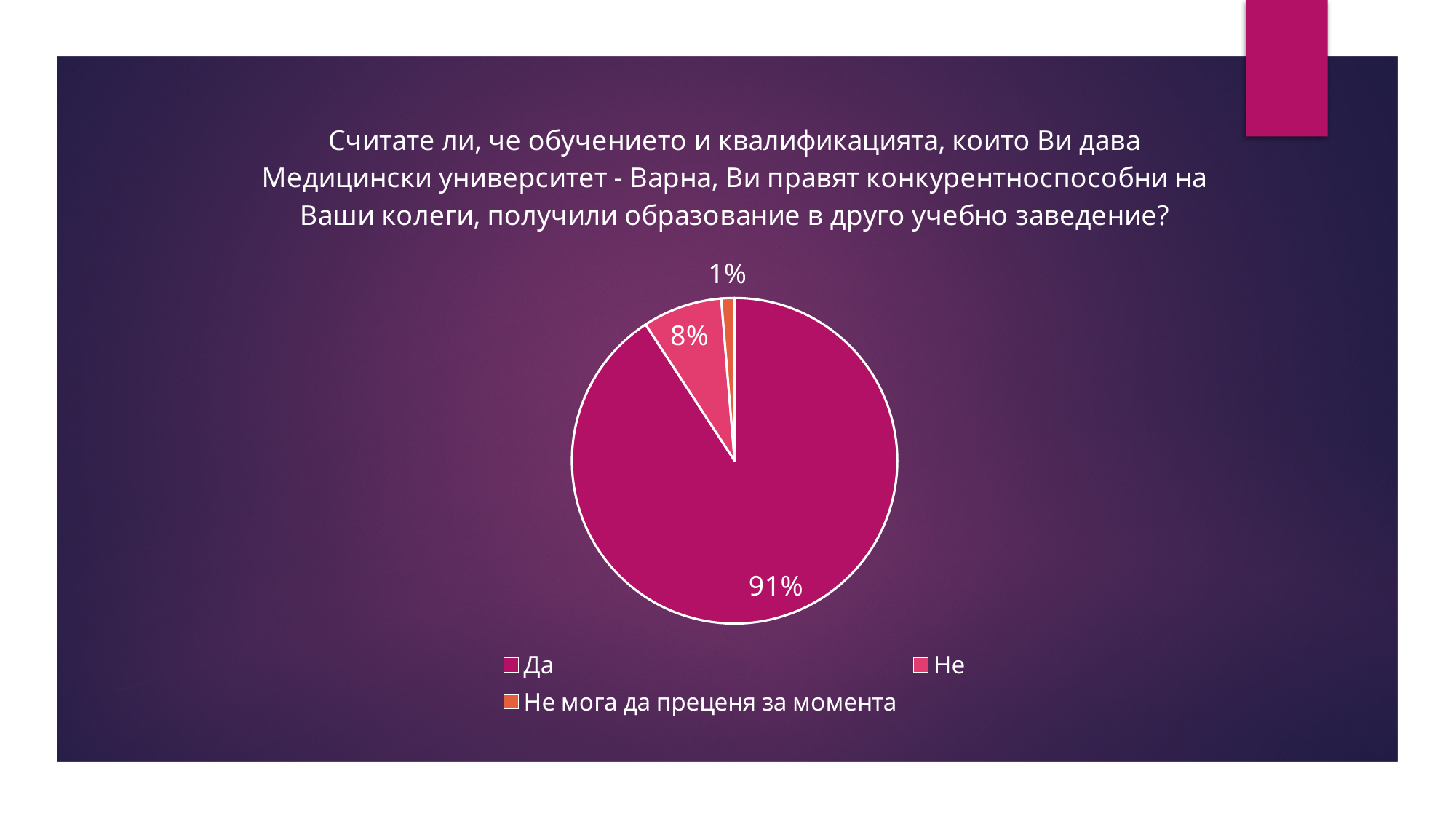
What share of the pie does "Не" have? 8% What share of the pie does "Не мога да преценя за момента" have? 1% What kind of chart is shown on the slide? pie chart Which category has the largest slice of the pie? Да How many categories does the pie chart have? 3 Which legend entry is shown in orange? Не мога да преценя за момента What is the difference in percentage points between the "Да" and "Не" slices? 83 Which category has the smallest slice of the pie? Не мога да преценя за момента How many entries does the legend list? 3 What is the difference in percentage points between the "Не" slice and the "Не мога да преценя за момента" slice? 7 Which slice is larger, "Не" or "Не мога да преценя за момента"? Не What share of the pie does "Да" have? 91%